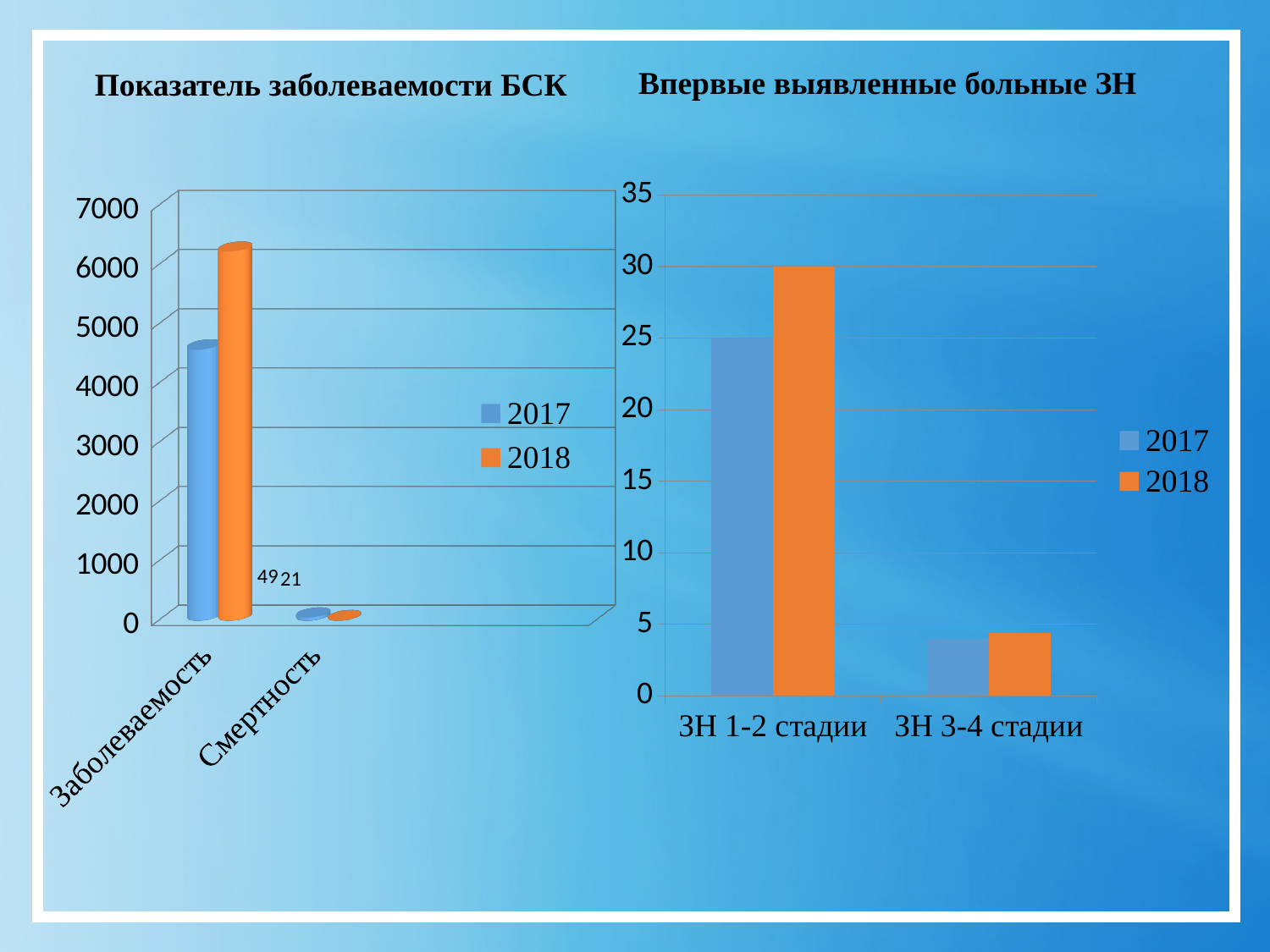
In the chart titled 'Впервые выявленные больные ЗН', which year has the larger value for ЗН 3-4 стадии, 2017 or 2018? 2018 What kind of chart is the one titled 'Показатель заболеваемости БСК'? bar chart In the chart titled 'Впервые выявленные больные ЗН', how many series does the legend list? 2 In the chart titled 'Показатель заболеваемости БСК', is the 2018 value for Заболеваемость greater or less than 6000? greater In the chart titled 'Впервые выявленные больные ЗН', how many categories are shown on the x axis? 2 In the chart titled 'Показатель заболеваемости БСК', what is the difference between the 2017 and 2018 values for Смертность? 28 In the chart titled 'Впервые выявленные больные ЗН', which category has the highest value for 2018? ЗН 1-2 стадии In the chart titled 'Показатель заболеваемости БСК', is the 2017 value for Заболеваемость greater or less than 5000? less In the chart titled 'Показатель заболеваемости БСК', what is the value for 2018 in the Смертность category? 21 In the chart titled 'Показатель заболеваемости БСК', which year has the larger value for Заболеваемость, 2017 or 2018? 2018 In the chart titled 'Показатель заболеваемости БСК', what is the value for 2017 in the Смертность category? 49 In the chart titled 'Впервые выявленные больные ЗН', is the 2018 value for ЗН 1-2 стадии greater or less than 25? greater